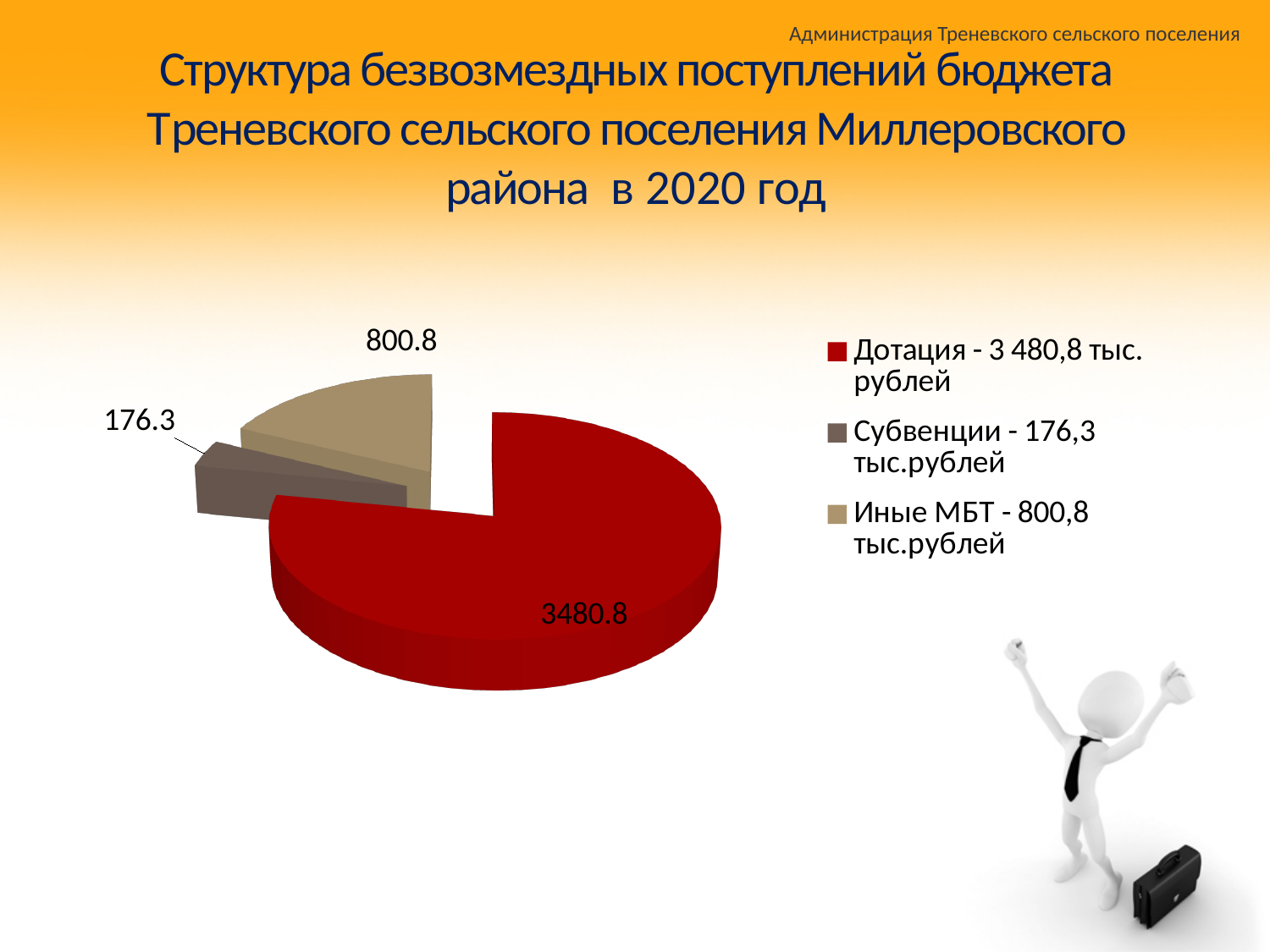
What type of chart is shown on the slide? Pie chart How many slices does the pie chart have? 3 What is the value shown for the Субвенции slice? 176.3 How many entries does the legend list? 3 What is the value shown for the Дотация slice? 3480.8 What is the value shown for the Иные МБТ slice? 800.8 What is the difference between the Иные МБТ value and the Субвенции value? 624.5 Which category has the largest slice of the pie? Дотация Which category has the smallest slice of the pie? Субвенции What colour is the Дотация slice? Red What is the difference between the Дотация value and the Иные МБТ value? 2680 Which is larger, Иные МБТ or Субвенции? Иные МБТ